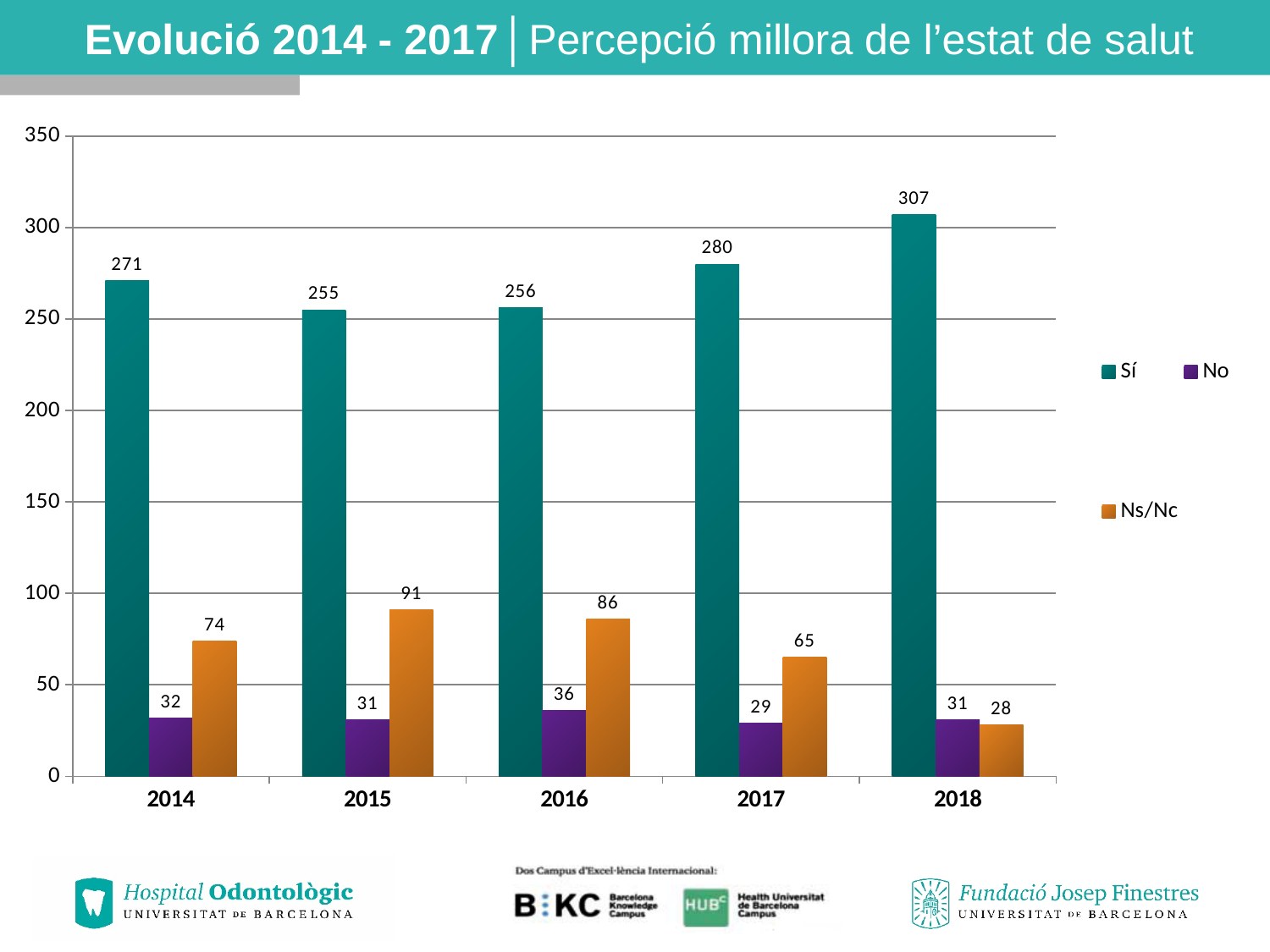
What is the difference between the Sí values for 2018 and 2014? 36 What kind of chart is shown on the slide? Bar chart How many years are shown on the x axis? 5 What is the value for No in 2017? 29 What is the value for Ns/Nc in 2015? 91 What is the value for Sí in 2018? 307 Which is larger in 2016: the No value or the Ns/Nc value? Ns/Nc Is the Sí value for 2017 greater or less than 250? greater In which year is the Ns/Nc value lowest? 2018 Does the Sí value rise or fall from 2016 to 2018? Rise In which year is the Sí value highest? 2018 How many series does the legend list? 3